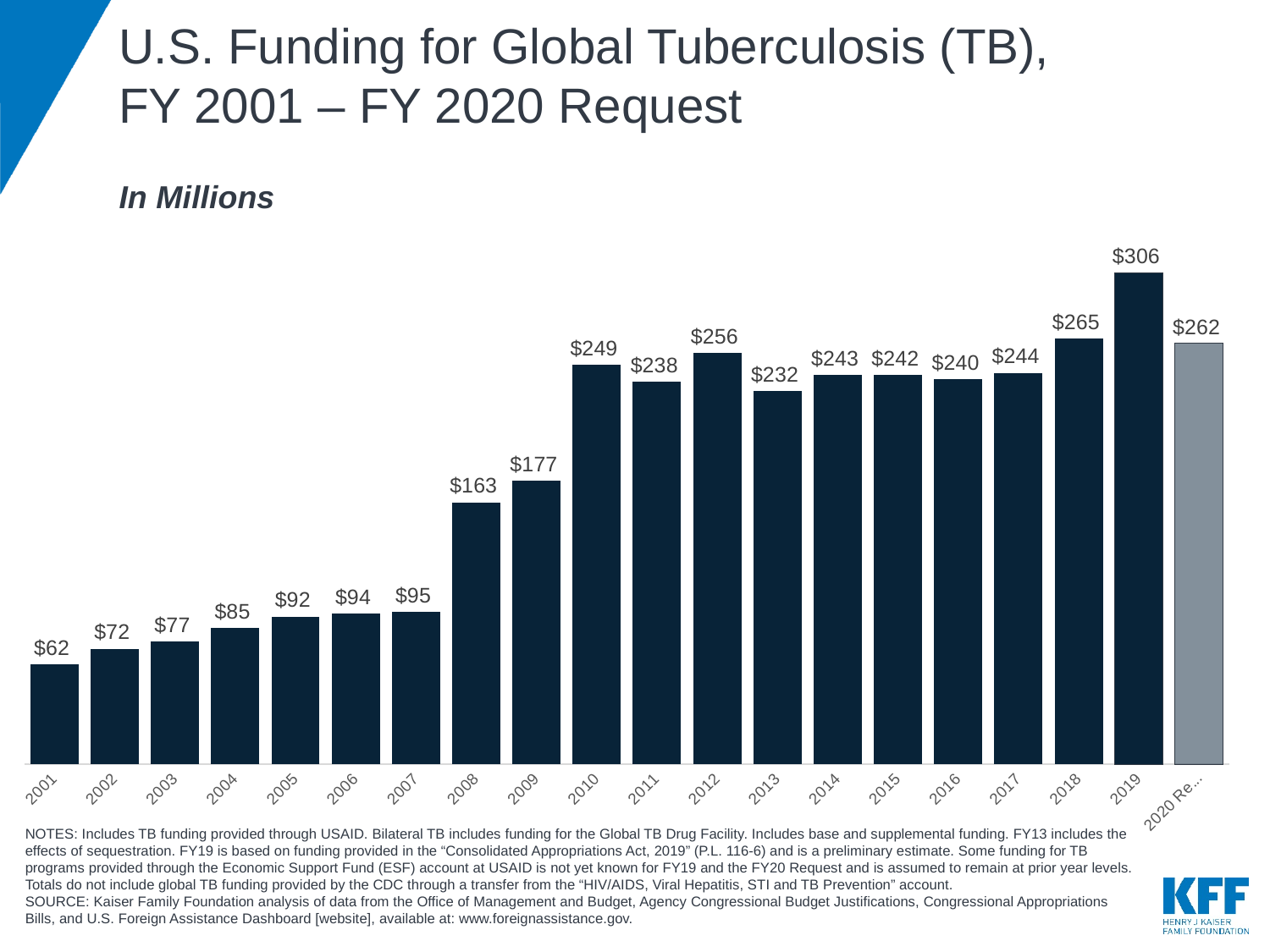
What is the U.S. funding for global TB in FY 2010? $249 What is the U.S. funding for global TB in FY 2001? $62 Which year has the lowest U.S. funding for global TB? 2001 What is the value shown for the 2020 Request? $262 Which bar is shown in a different colour (grey) from the others? 2020 Request How many bars are shown in the chart? 20 Does funding generally rise or fall from 2001 to 2010? Rise Which year has the highest U.S. funding for global TB? 2019 What is the difference between the 2019 funding and the 2020 Request? $44 Which is larger, the funding in 2012 or in 2013? 2012 How much did funding increase from 2007 to 2008? $68 What type of chart is shown on the slide? Bar chart